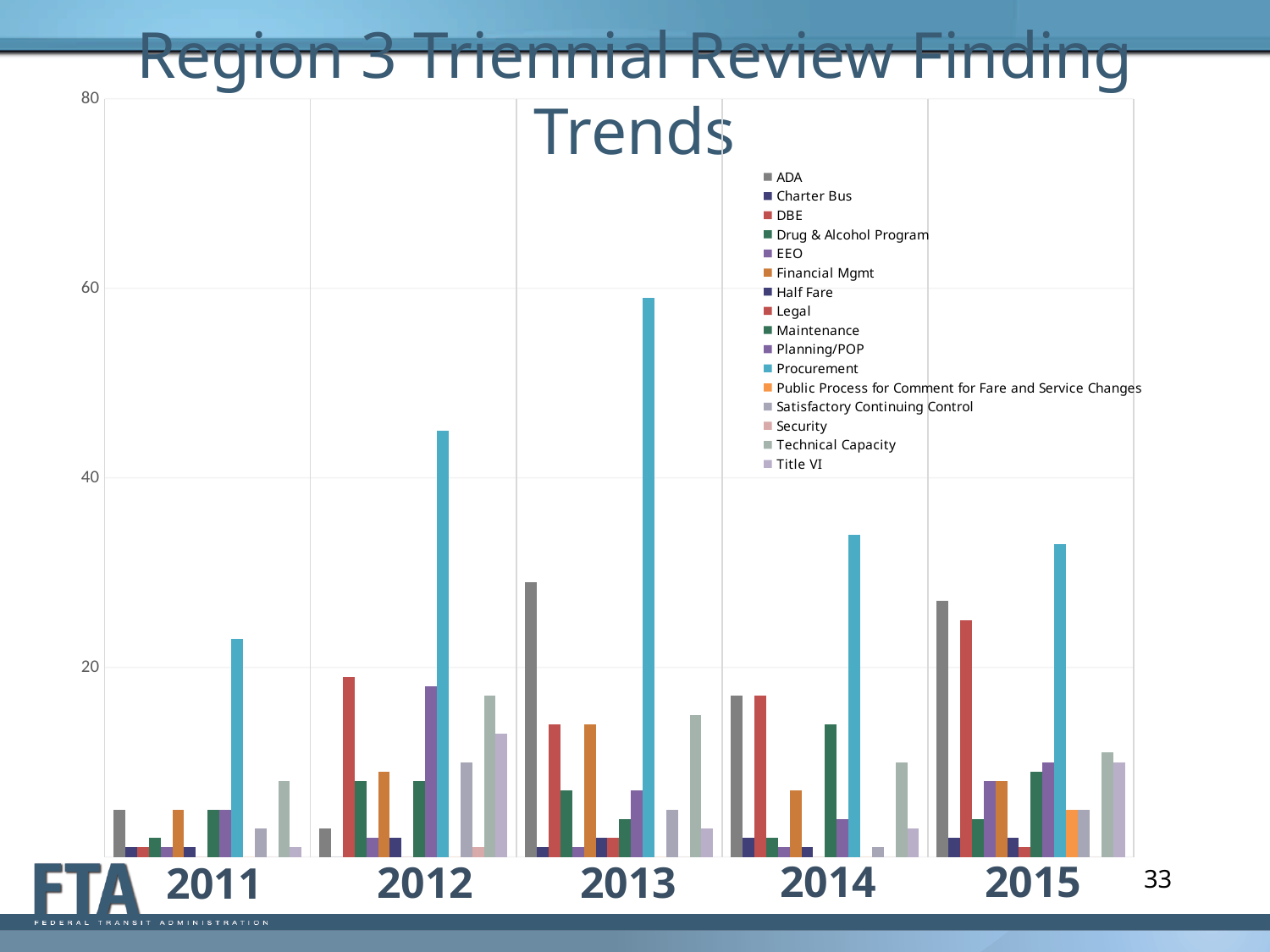
Is the value for Procurement in 2013 greater or less than 40? greater What kind of chart is shown on the slide? bar chart Is the value for Procurement in 2014 greater or less than 40? less In which year is the Procurement bar the tallest? 2013 How many series does the legend list? 16 Which is larger, the ADA bar for 2011 or the ADA bar for 2013? 2013 Is the value for ADA in 2013 greater or less than 20? greater How many years are shown along the x axis? 5 What is the title of the chart? Region 3 Triennial Review Finding Trends Which series has the tallest bar in 2015? Procurement Which series has the tallest bar in 2013? Procurement Which is larger, the Procurement bar for 2012 or the Procurement bar for 2013? 2013